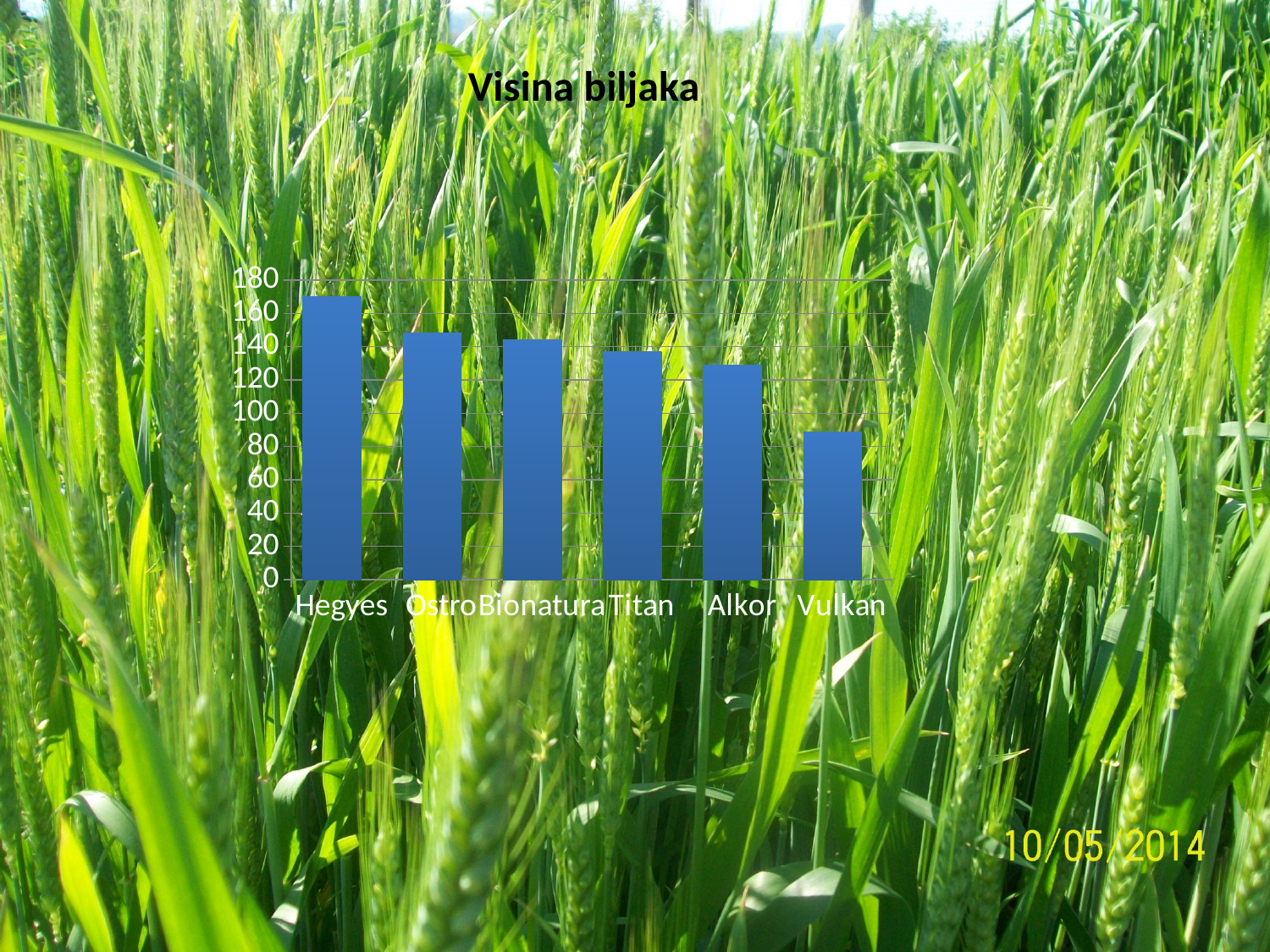
What kind of chart is shown on the slide? bar chart Is the value for Vulkan greater or less than 100? less How many categories are shown on the x axis of the chart? 6 Is the value for Ostro greater or less than 140? greater Which category has the lowest value in the chart? Vulkan Which is larger, the value for Ostro or the value for Alkor? Ostro Which is larger, the value for Titan or the value for Vulkan? Titan Which category has the highest value in the chart? Hegyes Is the value for Alkor greater or less than 120? greater Do the values rise or fall from left to right along the x axis? fall What is the title of the chart? Visina biljaka